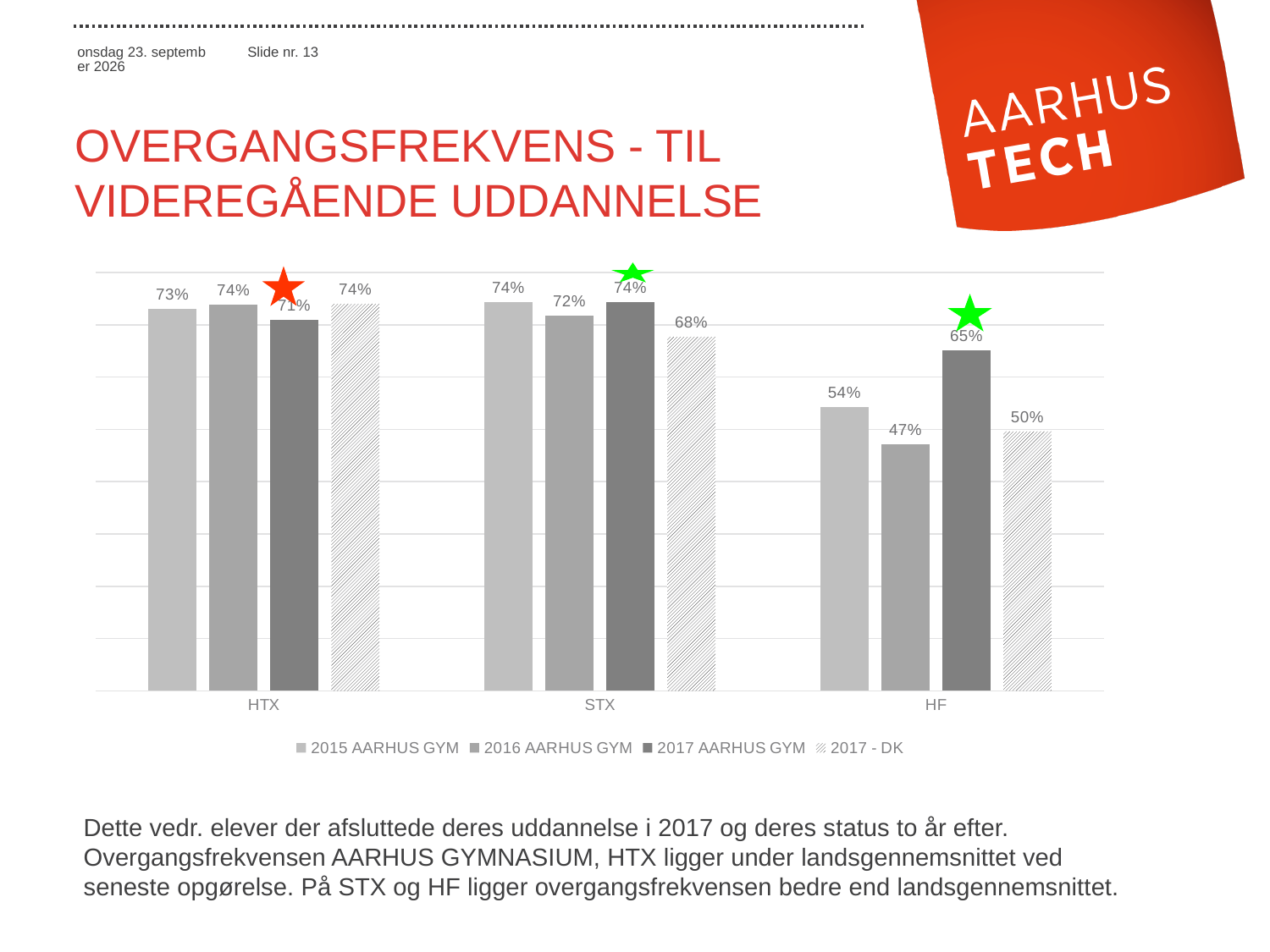
How many series does the legend list? 4 In the HTX category, which is larger: the 2017 AARHUS GYM value or the 2017 - DK value? 2017 - DK What is the difference between the 2017 AARHUS GYM value and the 2017 - DK value in the HF category? 15% What is the value for 2017 AARHUS GYM in the HF category? 65% What kind of chart is shown on the slide? Bar chart Which series has the highest value in the HF category? 2017 AARHUS GYM Which category has the lowest value for 2017 - DK? HF What is the value for 2017 - DK in the STX category? 68% What is the value for 2016 AARHUS GYM in the HF category? 47% Which series in the legend is drawn with a hatched pattern? 2017 - DK How many categories are shown on the x axis? 3 What is the value for 2015 AARHUS GYM in the HTX category? 73%